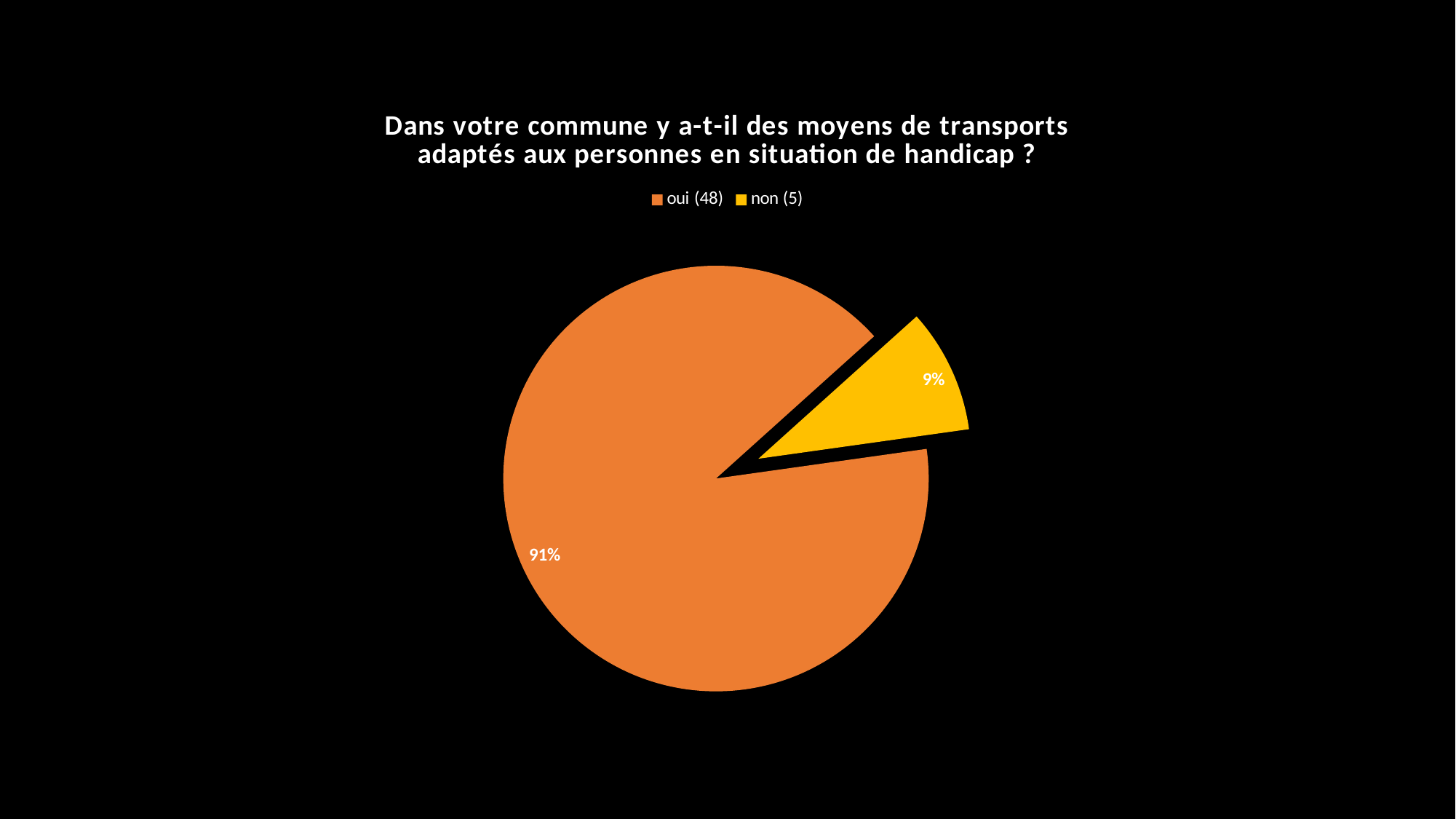
What is the title of the chart? Dans votre commune y a-t-il des moyens de transports adaptés aux personnes en situation de handicap ? Which slice is larger, "oui (48)" or "non (5)"? oui (48) Which slice is the largest in the pie chart? oui (48) Which slice is the smallest in the pie chart? non (5) What is the difference in percentage points between the "oui (48)" slice and the "non (5)" slice? 82 What share of the pie does the "non (5)" slice represent? 9% How many slices does the pie chart have? 2 What share of the pie does the "oui (48)" slice represent? 91% What colour is the "non (5)" slice? yellow How many entries does the legend list? 2 What kind of chart is shown on the slide? pie chart